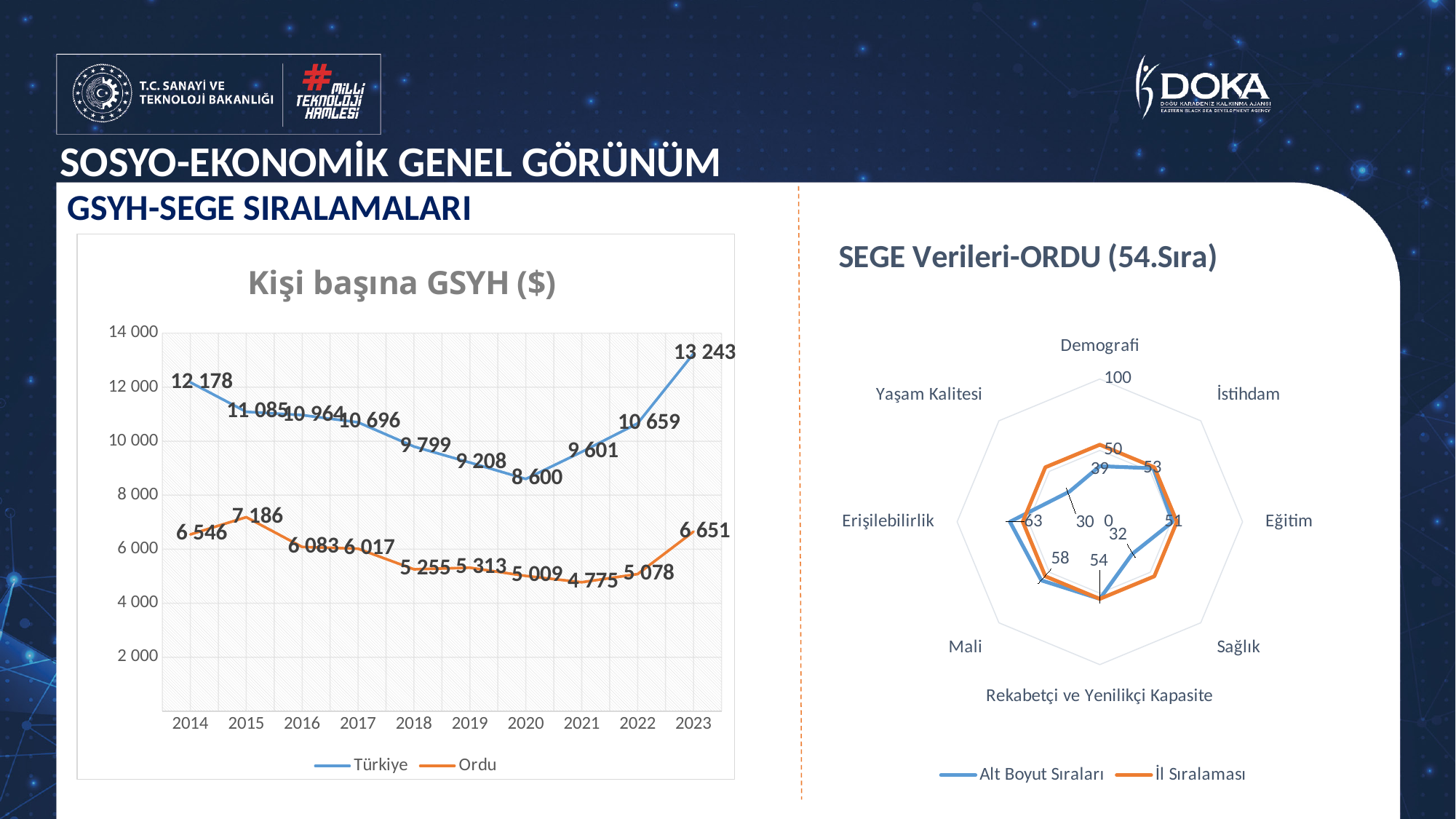
What kind of chart is the 'SEGE Verileri-ORDU (54.Sıra)' chart? radar chart In the 'Kişi başına GSYH ($)' chart, in which year is the Türkiye value highest? 2023 In the 'Kişi başına GSYH ($)' chart, what is the value for Ordu in 2021? 4 775 In the 'Kişi başına GSYH ($)' chart, which year has the larger Ordu value, 2015 or 2016? 2015 What kind of chart is the 'Kişi başına GSYH ($)' chart? line chart In the 'Kişi başına GSYH ($)' chart, does the Türkiye value rise or fall from 2014 to 2020? fall In the 'Kişi başına GSYH ($)' chart, how many series does the legend list? 2 In the 'Kişi başına GSYH ($)' chart, in which year is the Ordu value lowest? 2021 In the 'Kişi başına GSYH ($)' chart, what is the difference between the Türkiye and Ordu values in 2023? 6 592 In the 'Kişi başına GSYH ($)' chart, what is the value for Türkiye in 2023? 13 243 In the 'SEGE Verileri-ORDU (54.Sıra)' chart, how many categories are shown around the chart? 8 In the 'Kişi başına GSYH ($)' chart, how many years are shown on the x axis? 10